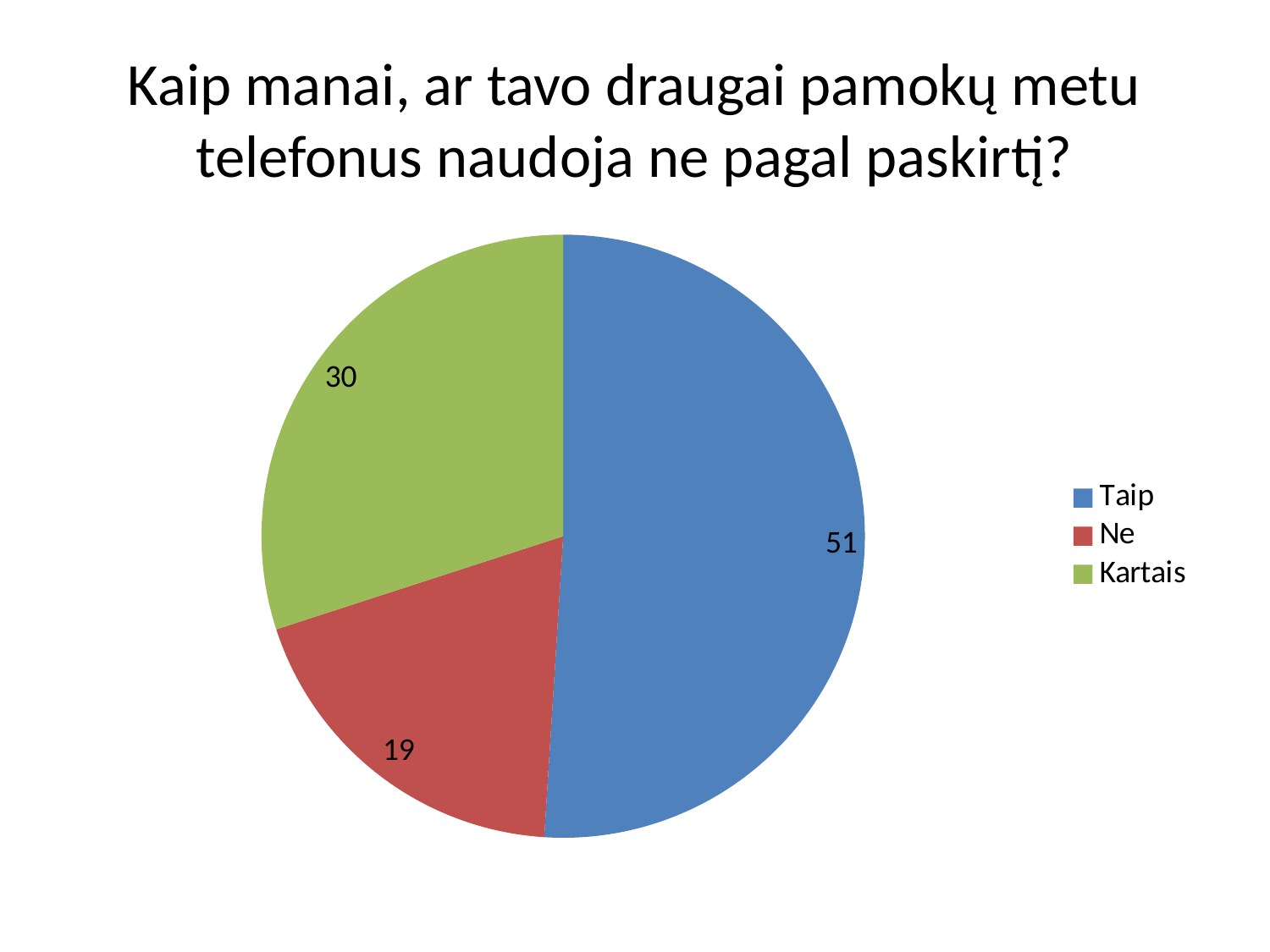
What is the value for Taip? 51 Which category has the smallest slice? Ne What kind of chart is shown on the slide? pie chart What is the difference between the values for Kartais and Ne? 11 What share of the pie does Taip represent? 51% Which category has the largest slice? Taip Which is larger, the value for Kartais or the value for Ne? Kartais What is the value for Kartais? 30 What is the difference between the values for Taip and Ne? 32 How many categories does the pie chart show? 3 What is the value for Ne? 19 What colour is the Kartais slice? green